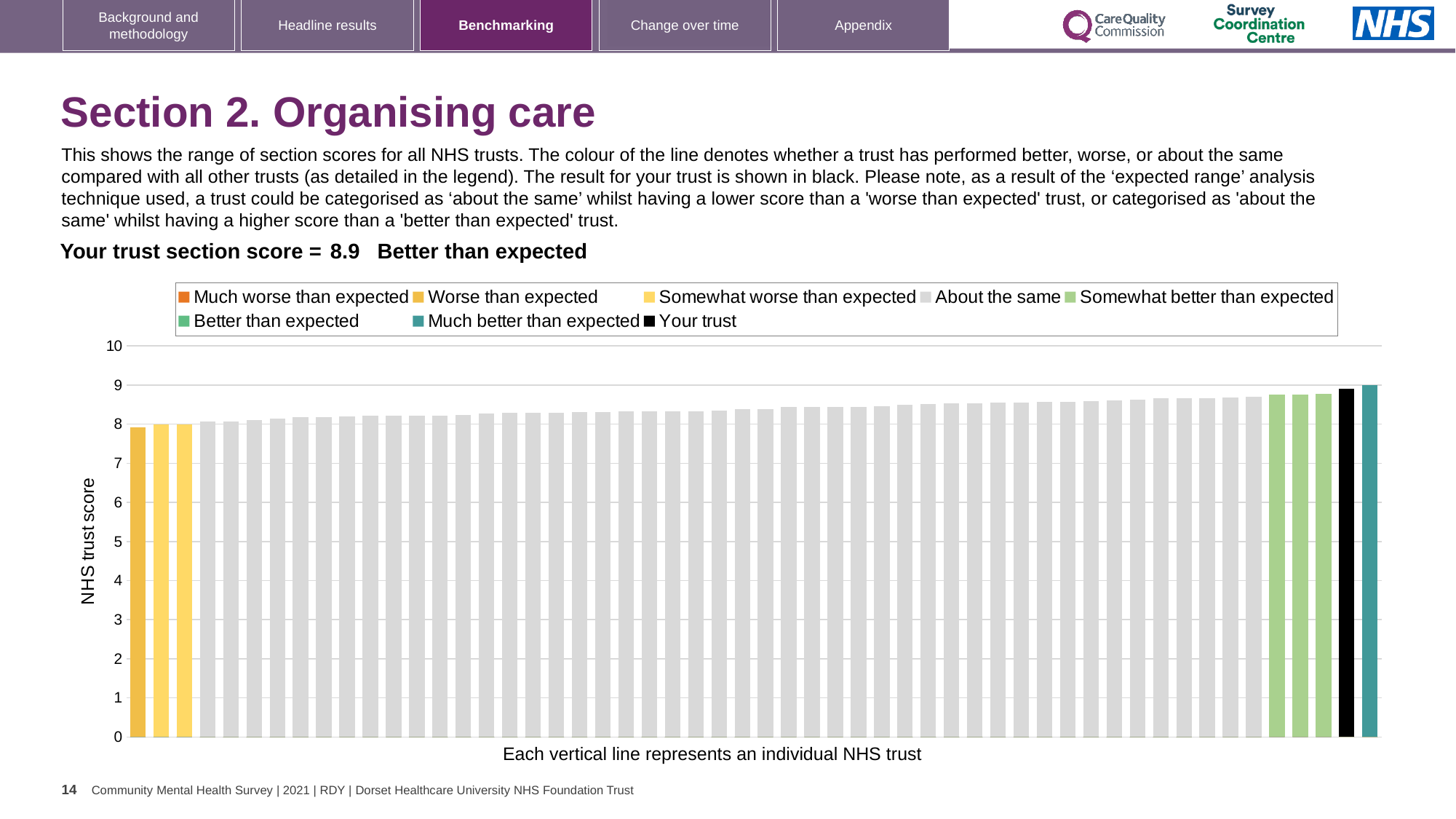
Is the value for the rightmost bar greater or less than 8? greater Do the bar values rise or fall from left to right along the x axis? rise What kind of chart is shown on the slide? bar chart What is your trust's section score for Organising care? 8.9 Which category is your trust's section score placed in? Better than expected How many entries does the chart legend list? 8 Is the value for the leftmost bar greater or less than 5? greater Is the value for your trust greater or less than 8? greater What colour is the bar representing your trust? black Which is larger, the value for your trust or the value for the leftmost bar? your trust What is the label on the vertical axis of the chart? NHS trust score